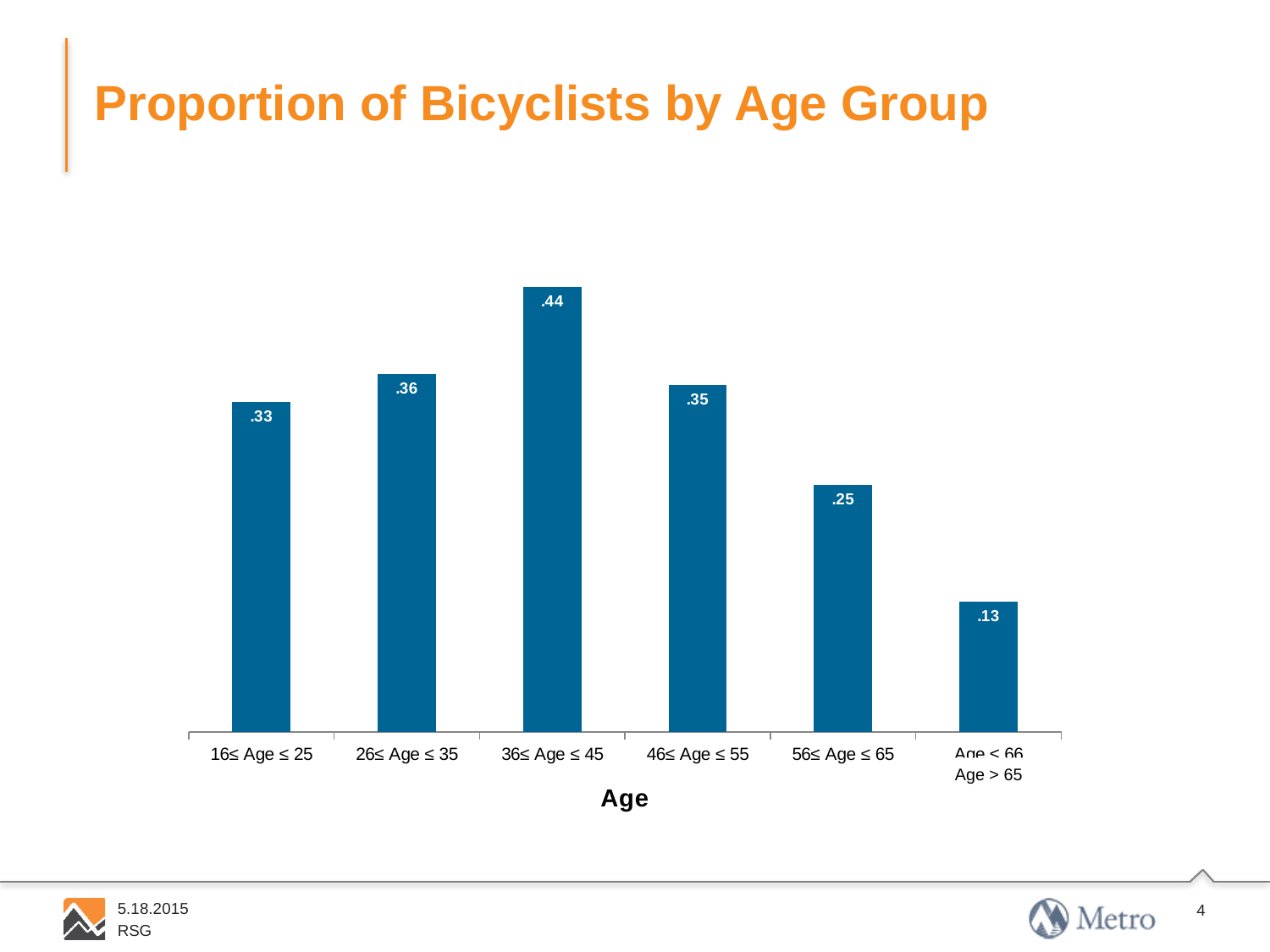
What is the difference between the proportion for 36≤ Age ≤ 45 and the proportion for 56≤ Age ≤ 65? .19 What is the label of the x axis? Age What is the proportion of bicyclists for the 16≤ Age ≤ 25 group? .33 What is the proportion of bicyclists for the 56≤ Age ≤ 65 group? .25 What kind of chart is shown on the slide? Bar chart Which age group has the highest proportion of bicyclists? 36≤ Age ≤ 45 What is the proportion of bicyclists for the 36≤ Age ≤ 45 group? .44 What is the proportion of bicyclists for the Age > 65 group? .13 How many age groups are shown in the chart? 6 Which age group has the lowest proportion of bicyclists? Age > 65 What is the difference between the proportion for 26≤ Age ≤ 35 and the proportion for 16≤ Age ≤ 25? .03 Which has a larger proportion of bicyclists, the 46≤ Age ≤ 55 group or the 56≤ Age ≤ 65 group? 46≤ Age ≤ 55